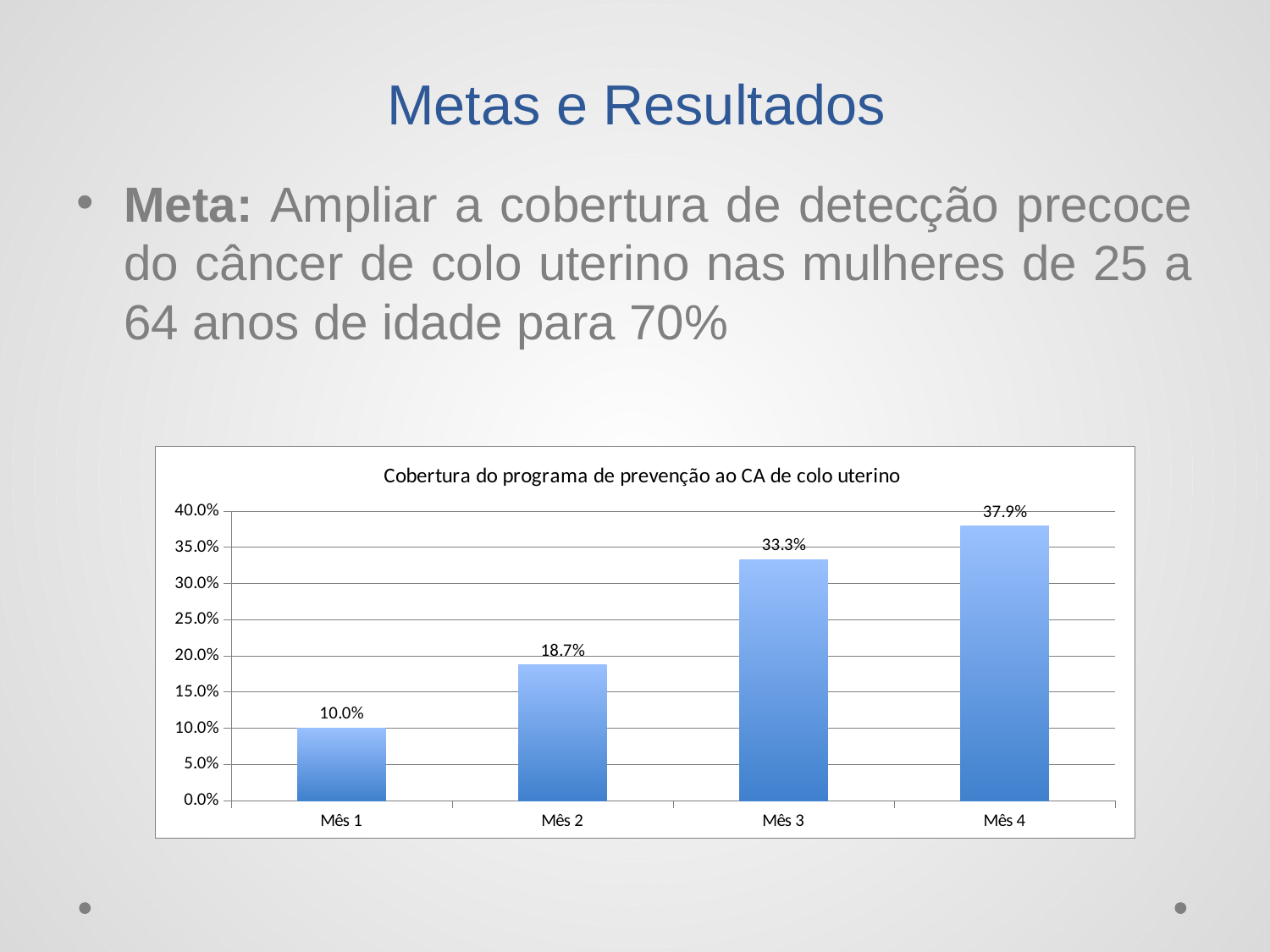
What is the difference between the values for Mês 2 and Mês 1? 8.7% Which month has the highest coverage? Mês 4 Which is larger, the value for Mês 2 or the value for Mês 3? Mês 3 How many months are shown on the x axis? 4 Which month has the lowest coverage? Mês 1 Do the values rise or fall from Mês 1 to Mês 4? Rise What is the difference between the values for Mês 4 and Mês 3? 4.6% What is the value for Mês 1? 10.0% What kind of chart is shown on the slide? Bar chart What is the value for Mês 2? 18.7% What is the value for Mês 4? 37.9% What is the value for Mês 3? 33.3%